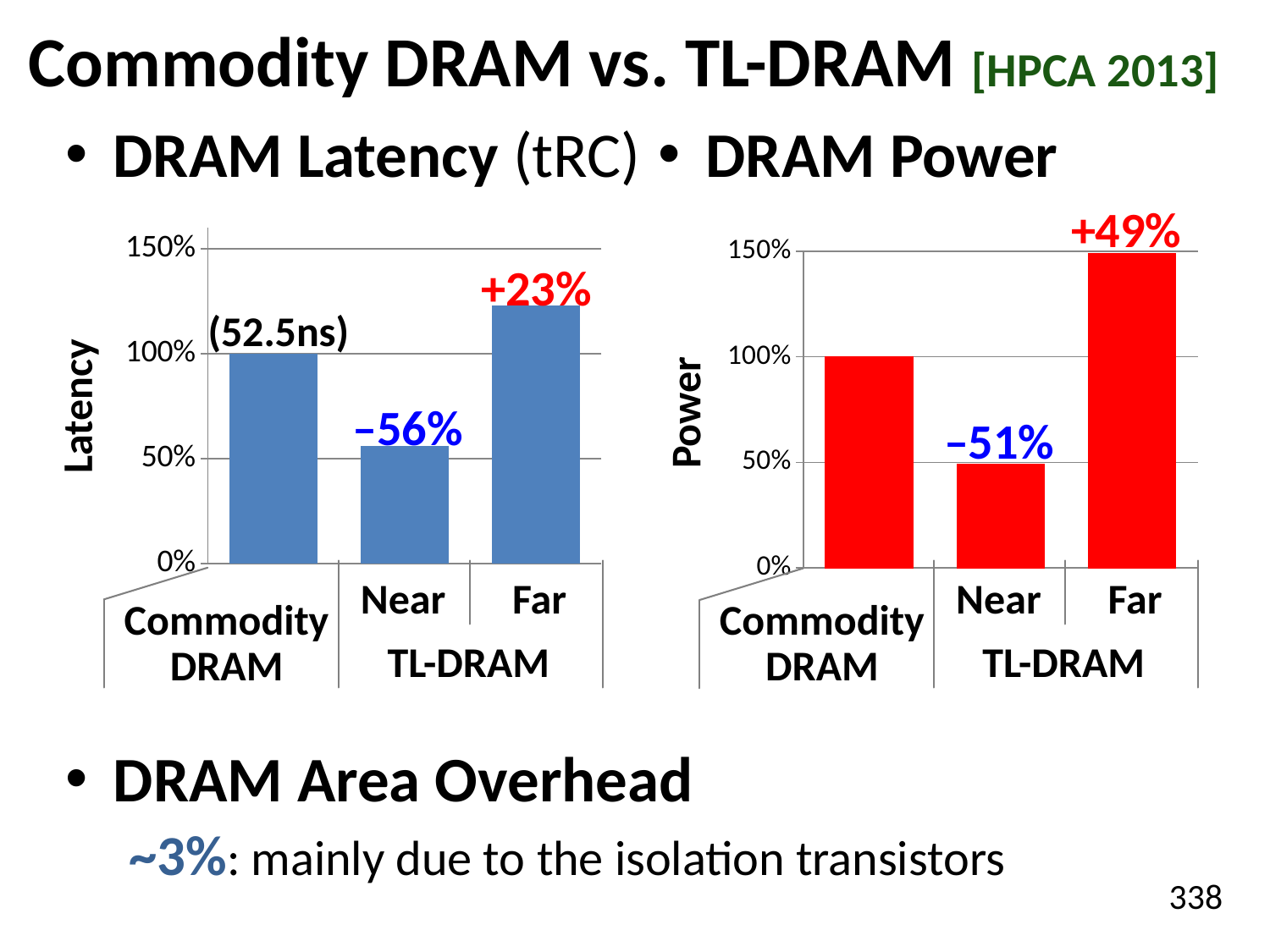
In the DRAM Latency chart on the left, is the value for TL-DRAM Far greater or less than 100%? greater In the DRAM Latency chart on the left, what percentage change is labelled on the TL-DRAM Near bar? –56% In the DRAM Power chart on the right, what percentage change is labelled on the TL-DRAM Near bar? –51% In the DRAM Power chart on the right, what percentage change is labelled on the TL-DRAM Far bar? +49% In the DRAM Latency chart on the left, what absolute latency is printed above the Commodity DRAM bar? (52.5ns) In the DRAM Latency chart on the left, what percentage change is labelled on the TL-DRAM Far bar? +23% In the DRAM Latency chart on the left, what kind of chart is used? bar chart In the DRAM Latency chart on the left, how many bars are plotted? 3 In the DRAM Power chart on the right, what colour are the bars? red In the DRAM Latency chart on the left, what is the latency value for Commodity DRAM? 100% In the DRAM Power chart on the right, which bar is the highest? Far (TL-DRAM) In the DRAM Latency chart on the left, which bar is the lowest? Near (TL-DRAM)